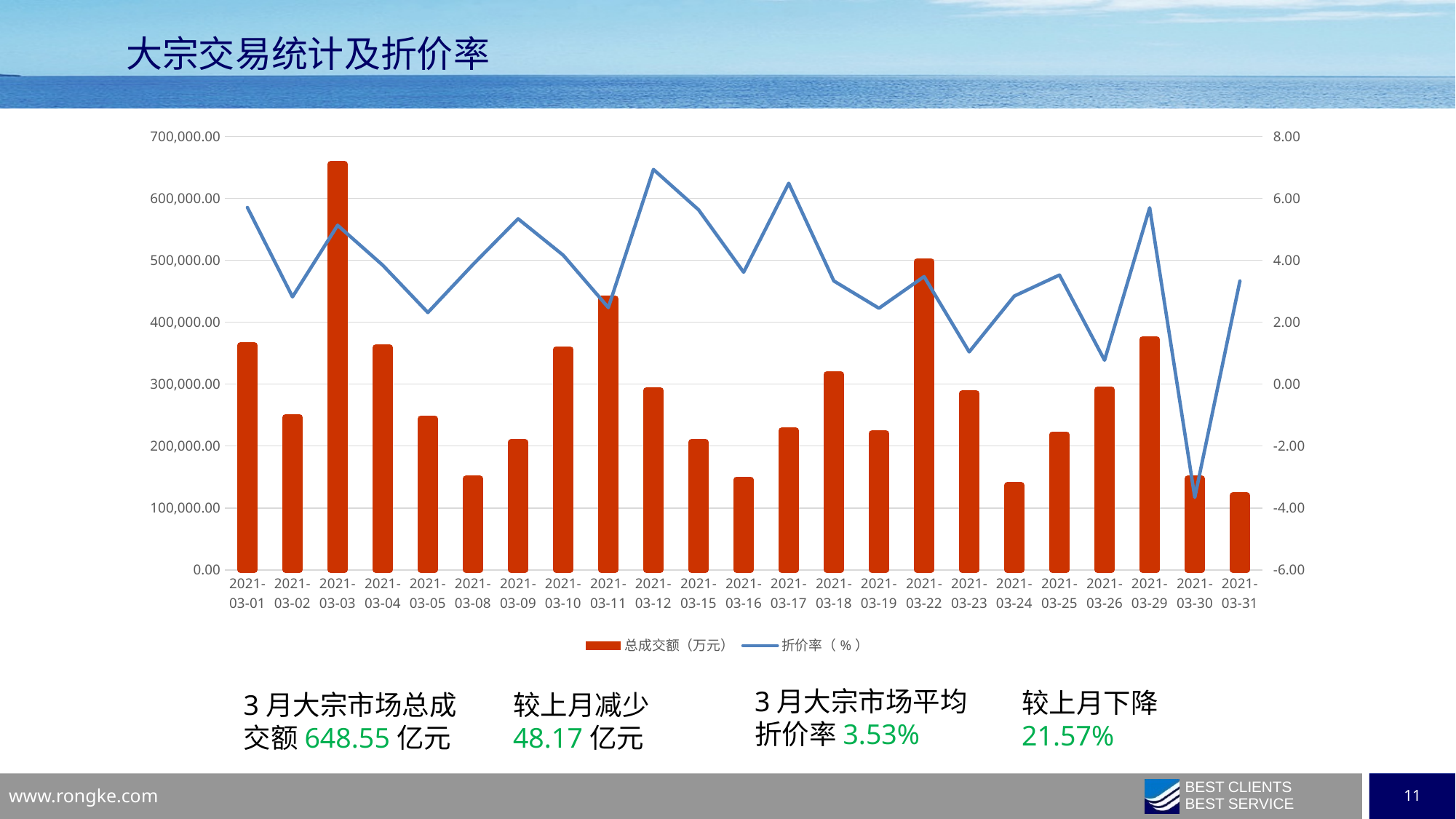
How many series does the chart legend list? 2 Is the 总成交额 value for 2021-03-08 greater or less than 200,000.00? less On which date does the 折价率 line reach its lowest point? 2021-03-30 On which date is the 总成交额 bar the highest? 2021-03-03 On which date does the 折价率 line reach its highest point? 2021-03-12 Is the 折价率 value for 2021-03-30 greater or less than 0.00? less Is the 总成交额 value for 2021-03-03 greater or less than 600,000.00? greater What is the title of the chart on the slide? 大宗交易统计及折价率 How many dates are shown on the x axis of the chart? 23 On which date is the 总成交额 bar the lowest? 2021-03-31 What kind of chart is shown on the slide? Combination bar and line chart Which date has the larger 总成交额 bar, 2021-03-01 or 2021-03-02? 2021-03-01